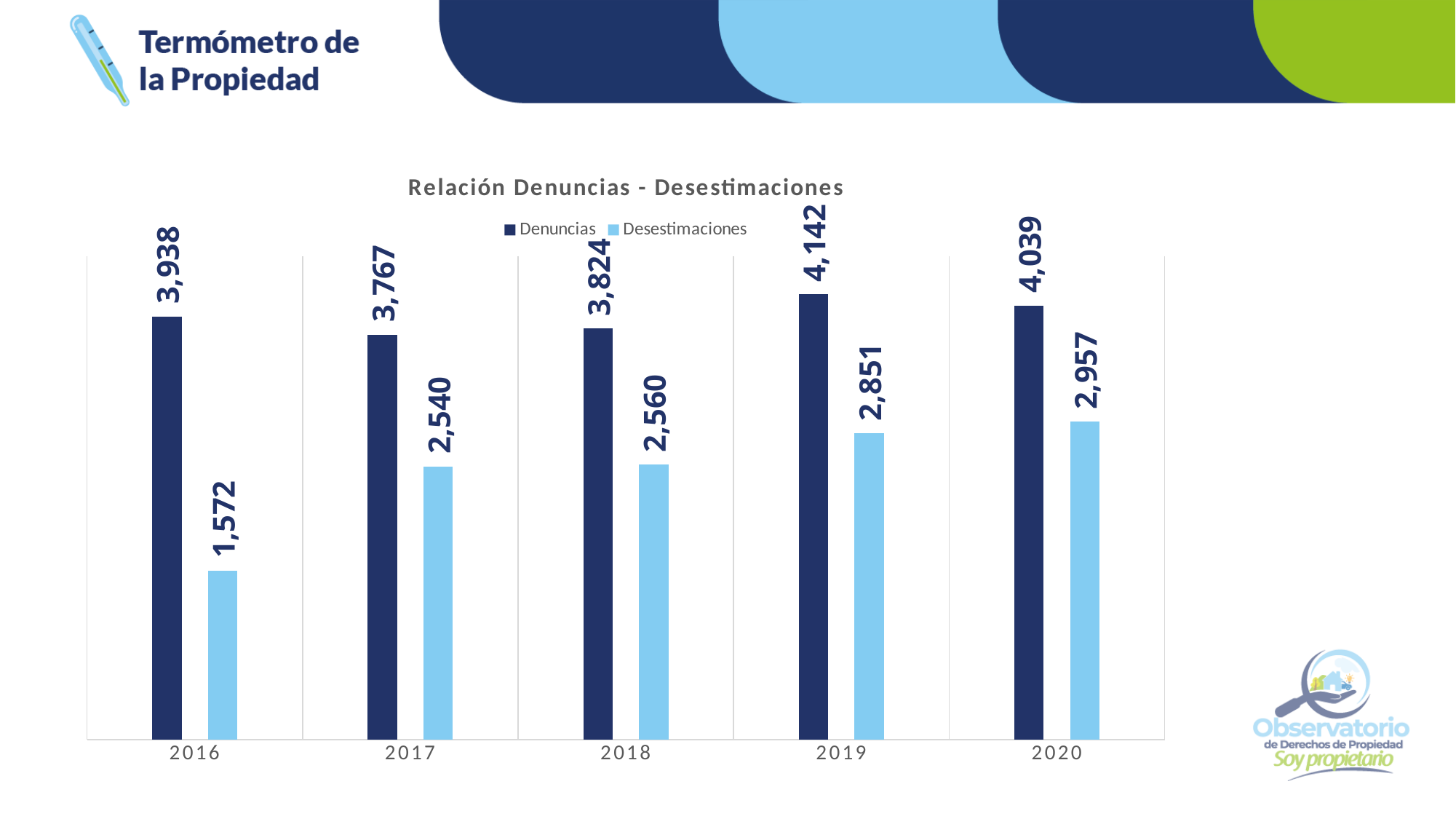
How many years are shown on the x axis? 5 Which year has the highest value for Denuncias? 2019 How many series does the legend list? 2 What is the value of Denuncias in 2016? 3,938 What is the title of the chart? Relación Denuncias - Desestimaciones What is the difference between Denuncias and Desestimaciones in 2019? 1,291 What is the value of Desestimaciones in 2018? 2,560 What is the value of Desestimaciones in 2020? 2,957 Which is larger, Denuncias in 2017 or Denuncias in 2018? Denuncias in 2018 What kind of chart is shown on the slide? Bar chart What is the difference between Desestimaciones in 2017 and in 2016? 968 Which year has the lowest value for Desestimaciones? 2016